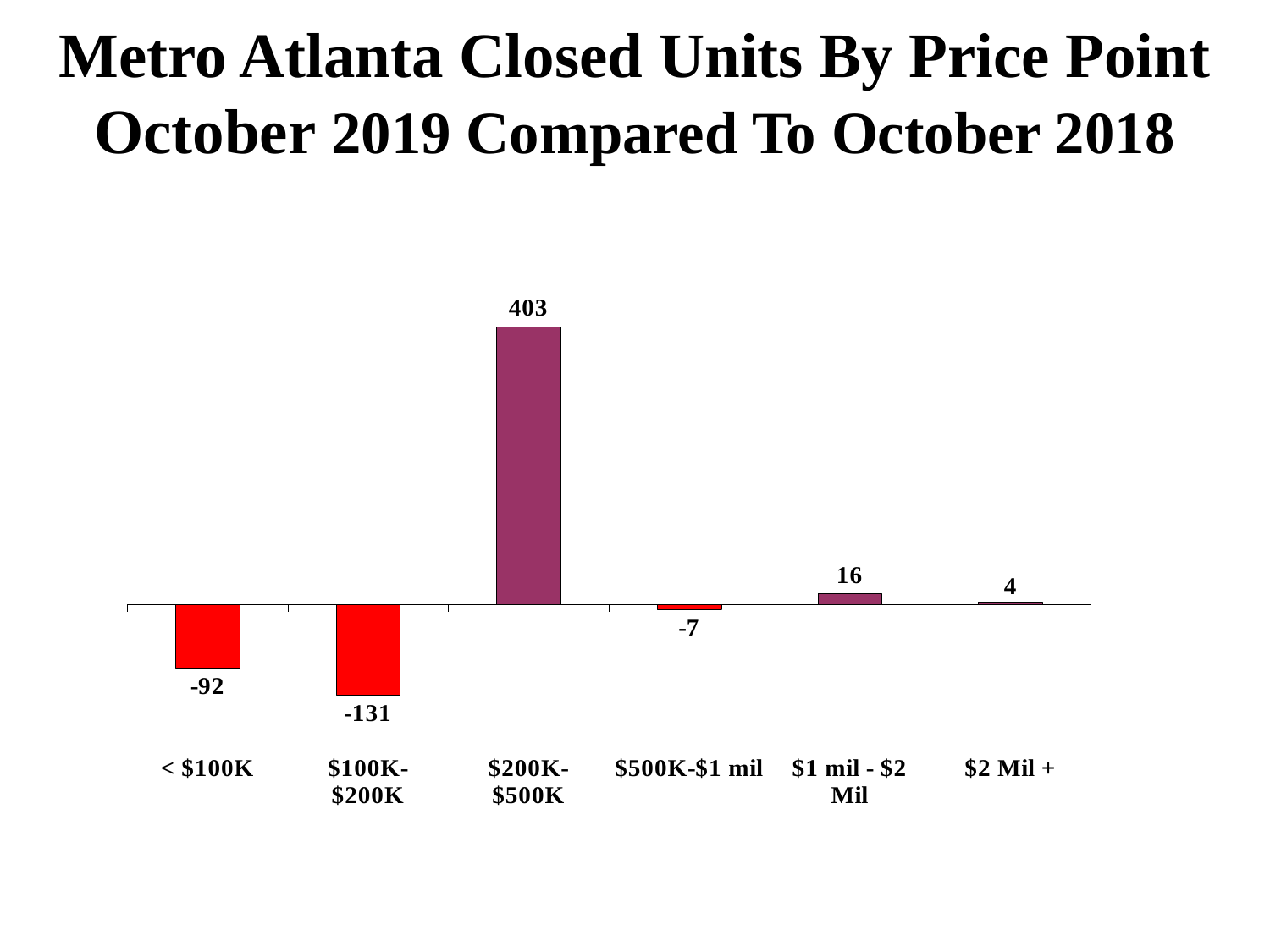
What is the value for the $100K-$200K price point? -131 What is the value for the $500K-$1 mil price point? -7 What kind of chart is shown on the slide? Bar chart Which price point has the lowest value? $100K-$200K Which price point has the highest value? $200K-$500K How many price points have a negative value? 3 Which is larger, the value for $1 mil - $2 Mil or the value for $2 Mil +? $1 mil - $2 Mil What is the value for the $2 Mil + price point? 4 What is the difference between the values for $200K-$500K and $1 mil - $2 Mil? 387 How many price point categories are shown on the chart? 6 What is the value for the < $100K price point? -92 What is the value for the $200K-$500K price point? 403